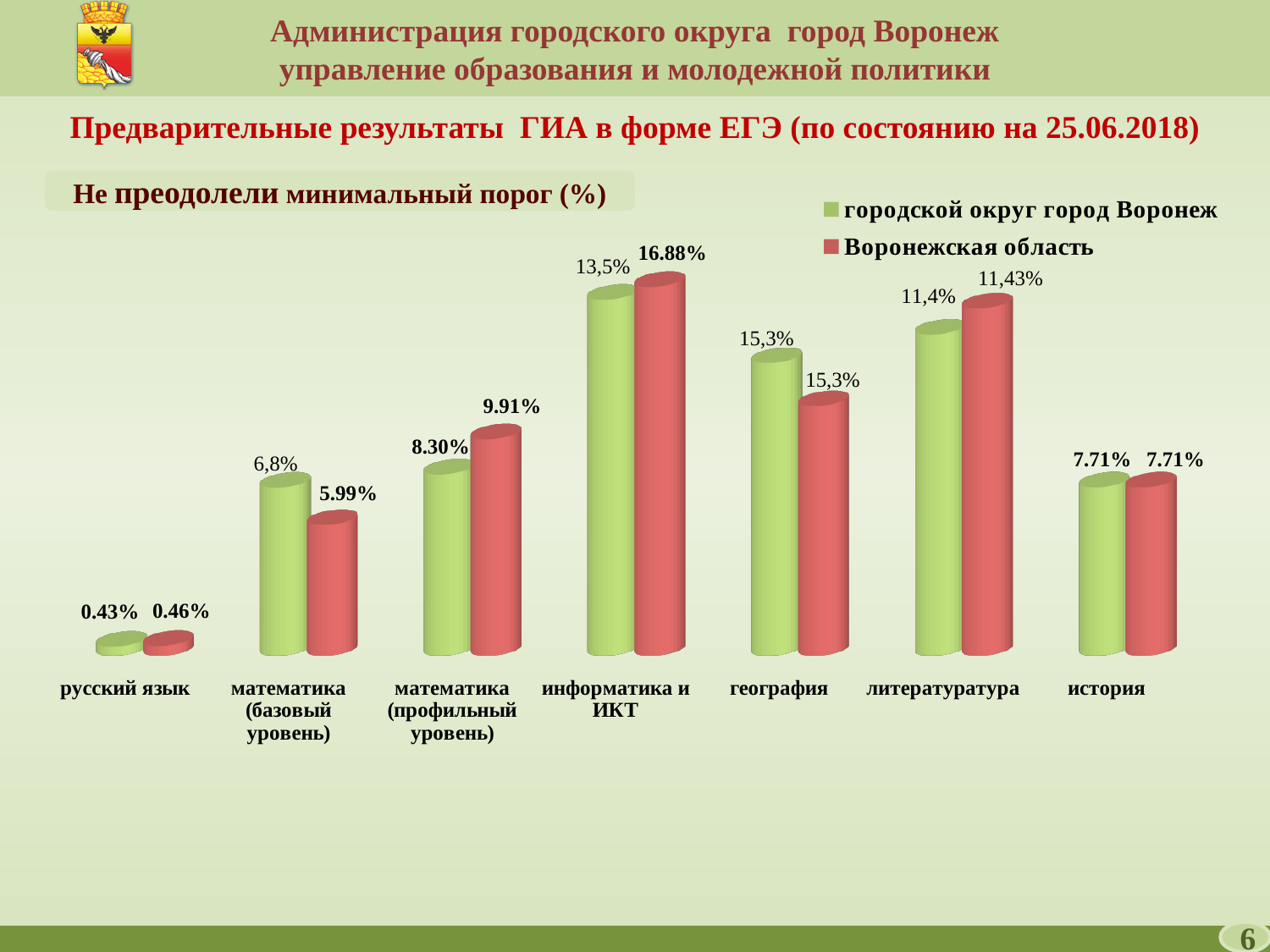
What is the value for Воронежская область in математика (профильный уровень)? 9.91% How many subject categories are shown on the chart? 7 Which category has the lowest values for both series? русский язык Which single bar is the highest on the chart? Воронежская область, информатика и ИКТ (16.88%) In математика (базовый уровень), which series has the larger value? городской округ город Воронеж What is the difference between Воронежская область and городской округ город Воронеж in математика (профильный уровень)? 1.61% What kind of chart is shown on the slide? bar chart What is the value for городской округ город Воронеж in русский язык? 0.43% How many series does the legend list? 2 What is the value for Воронежская область in информатика и ИКТ? 16.88% What is the value for городской округ город Воронеж in литературатура? 11,4%